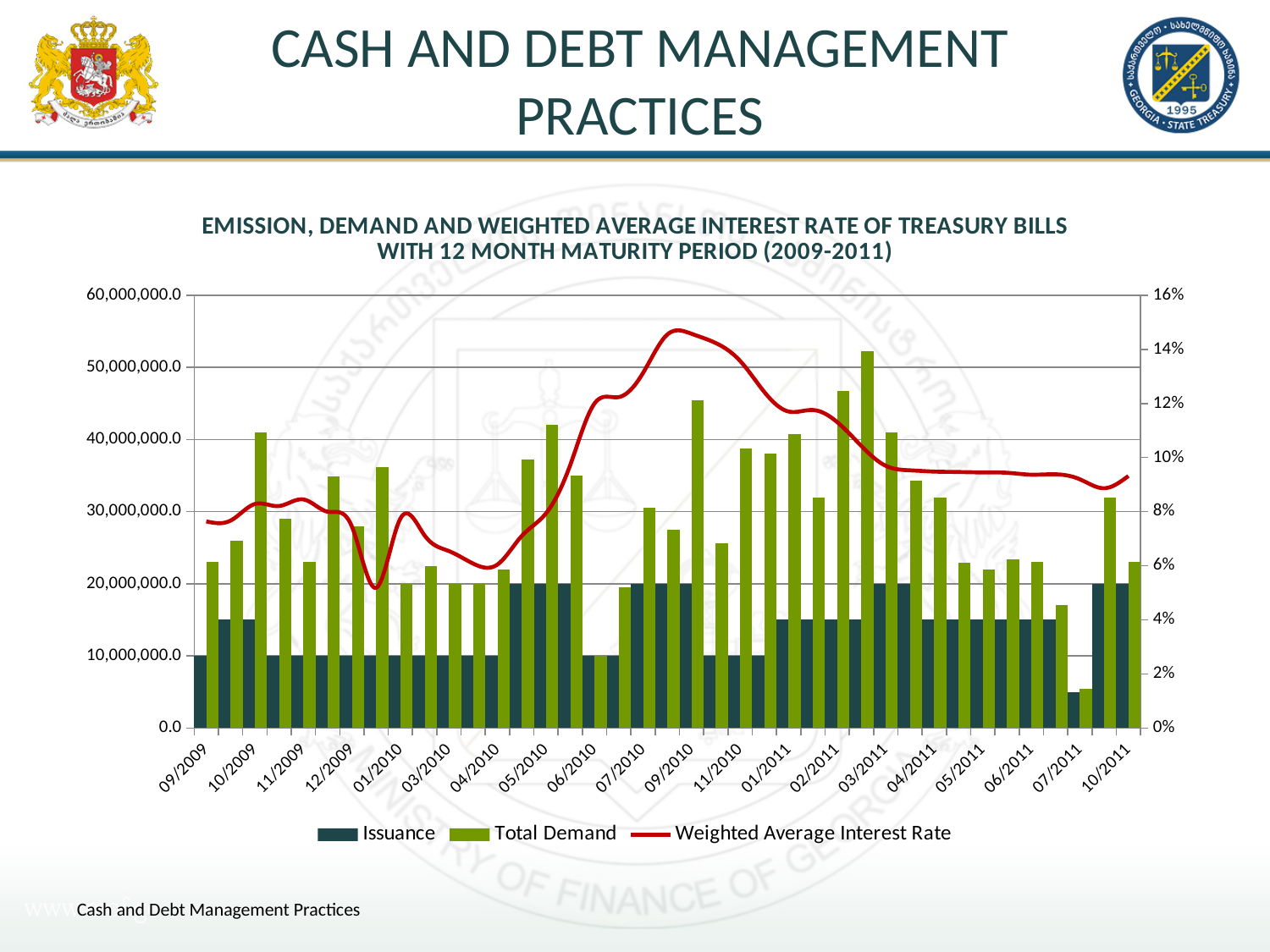
Is the peak of the Weighted Average Interest Rate line greater or less than 14%? greater What kind of chart is shown on the slide? A combination bar and line chart What is the maximum value shown on the right-hand percentage axis? 16% What is the Issuance value for 10/2011? 20,000,000.0 What is the title of the chart? EMISSION, DEMAND AND WEIGHTED AVERAGE INTEREST RATE OF TREASURY BILLS WITH 12 MONTH MATURITY PERIOD (2009-2011) Which series is plotted as a line rather than bars? Weighted Average Interest Rate What is the Issuance value for 09/2009? 10,000,000.0 Is the highest Total Demand bar greater or less than 50,000,000.0? greater For 09/2009, which is larger: Issuance or Total Demand? Total Demand Is the Weighted Average Interest Rate for 10/2011 greater or less than 10%? less Does the Weighted Average Interest Rate rise or fall between 04/2010 and 09/2010? Rise How many series does the legend list? 3